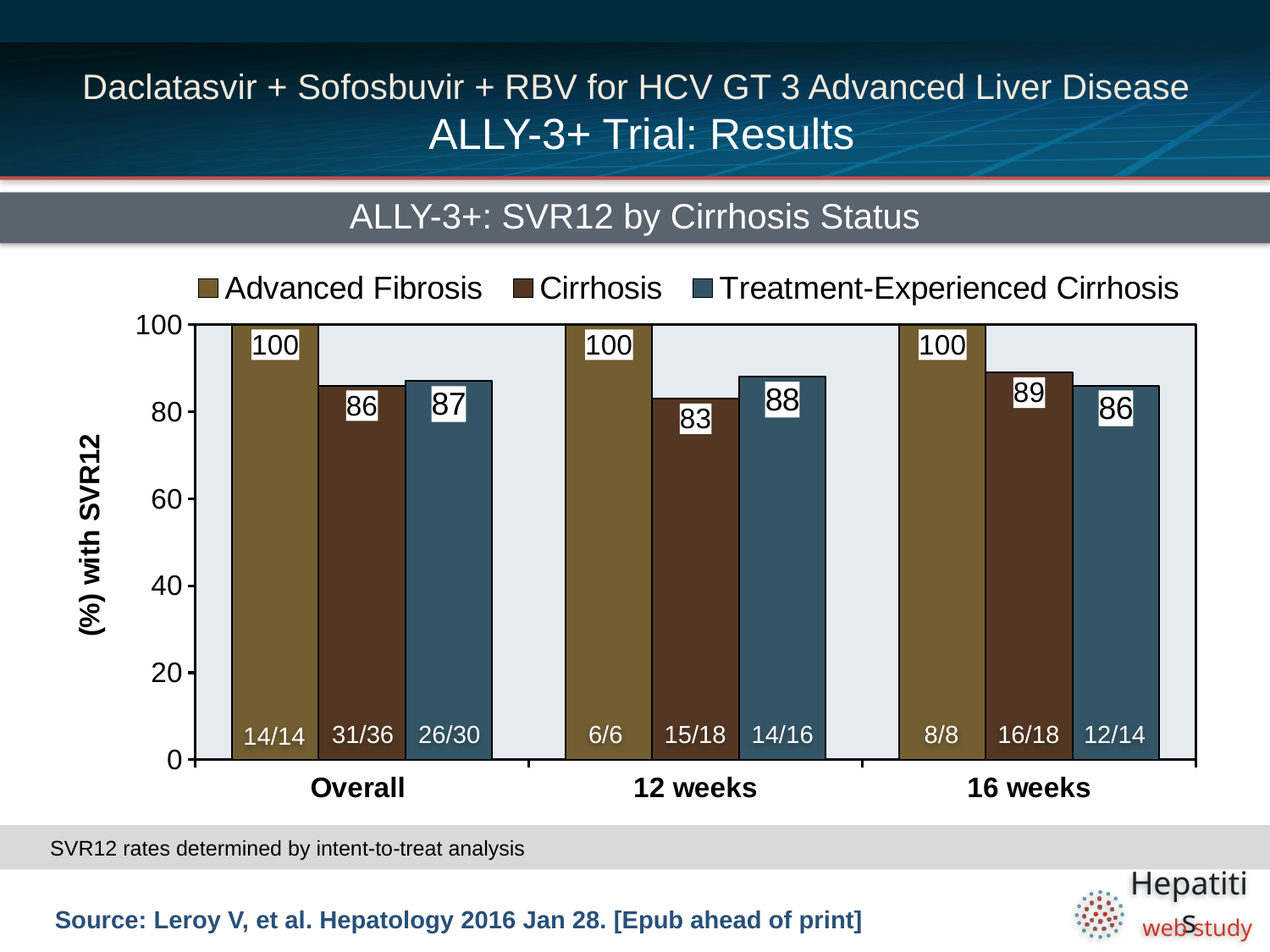
What is the SVR12 rate for Cirrhosis in the Overall group? 86 What is the SVR12 rate for Treatment-Experienced Cirrhosis at 12 weeks? 88 How many categories are shown on the x axis? 3 How many series does the legend list? 3 Which series has the highest SVR12 rate in the Overall group? Advanced Fibrosis What is the SVR12 rate for Cirrhosis at 16 weeks? 89 Which series has the lowest SVR12 rate at 12 weeks? Cirrhosis Which is larger at 16 weeks: the Cirrhosis rate or the Treatment-Experienced Cirrhosis rate? Cirrhosis What is the title of the chart? ALLY-3+: SVR12 by Cirrhosis Status What fraction of patients is shown for the Treatment-Experienced Cirrhosis bar in the Overall group? 26/30 What is the difference between the Advanced Fibrosis and Cirrhosis SVR12 rates at 12 weeks? 17 What kind of chart is shown on the slide? Bar chart